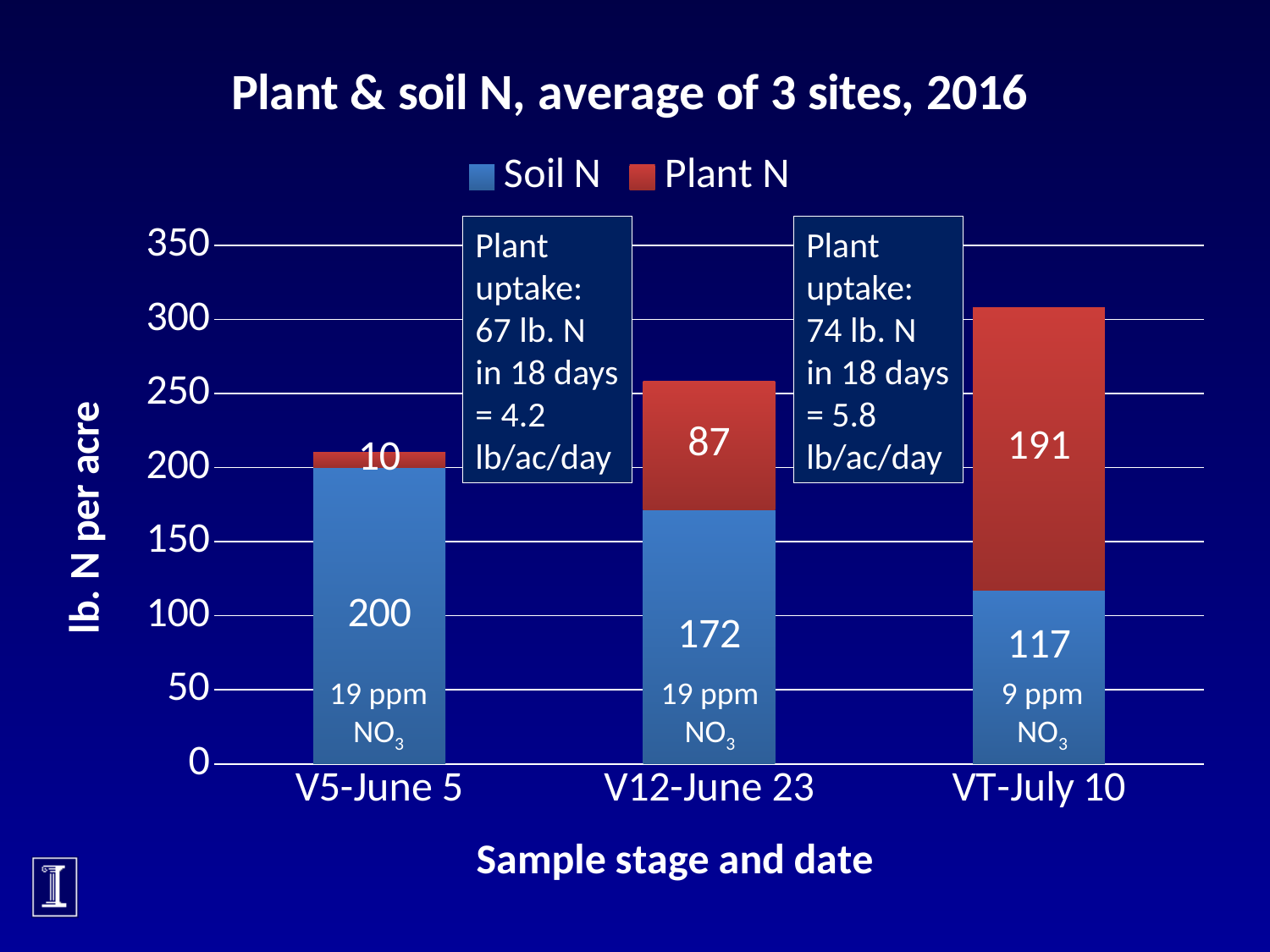
Which is larger, the Plant N value for V12-June 23 or the Plant N value for VT-July 10? VT-July 10 How many sample stages are shown on the x axis? 3 What is the Plant N value for V12-June 23? 87 What is the Plant N value for VT-July 10? 191 How many series does the legend list? 2 What is the Soil N value for VT-July 10? 117 What kind of chart is shown on the slide? Stacked bar chart What is the difference between the Soil N values for V5-June 5 and V12-June 23? 28 What is the Soil N value for V5-June 5? 200 Which sample stage has the lowest Soil N value? VT-July 10 What is the total of the stacked bar for VT-July 10? 308 Which sample stage has the highest Plant N value? VT-July 10